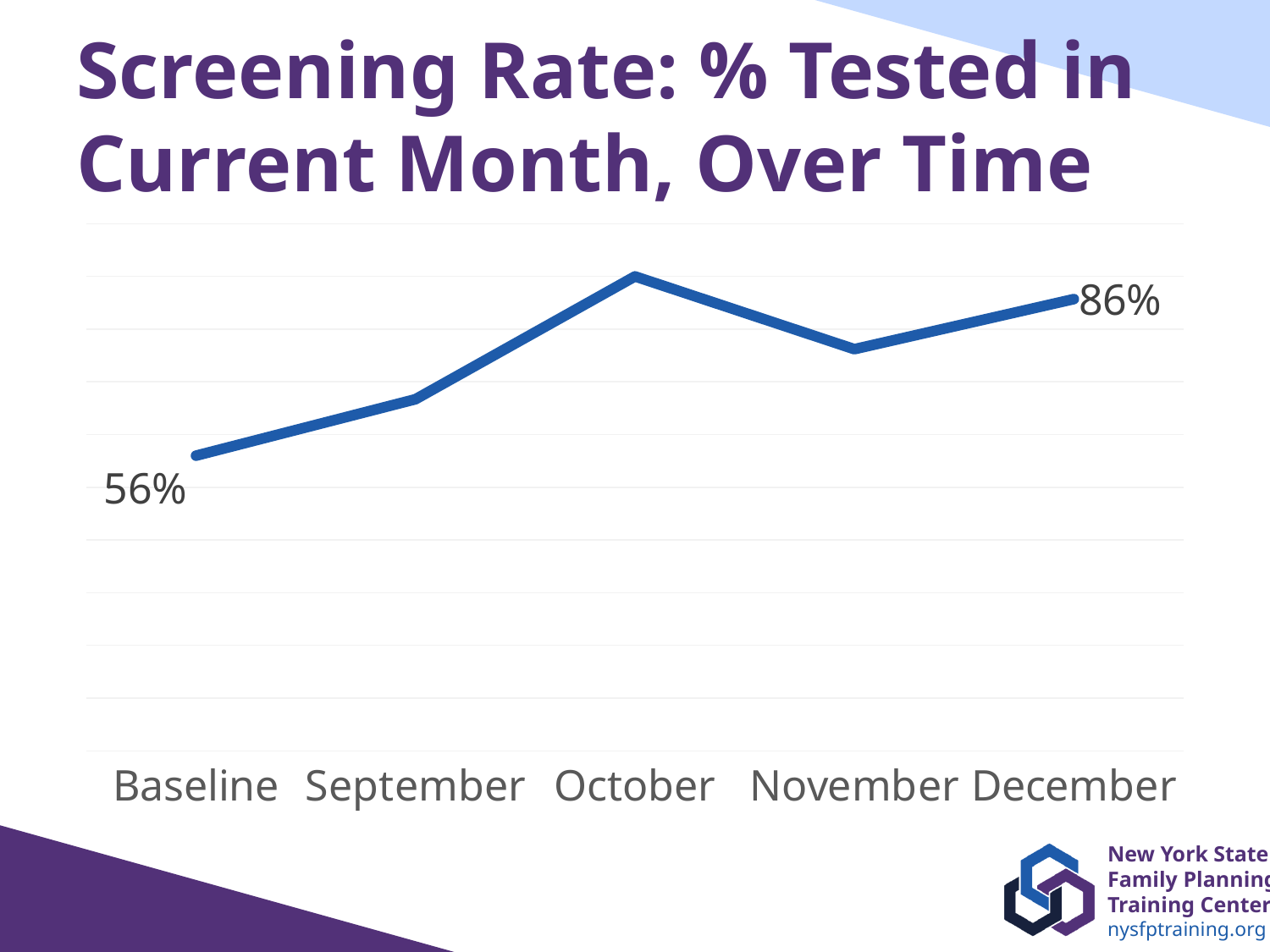
What is the title of the chart on the slide? Screening Rate: % Tested in Current Month, Over Time How many time points are plotted on the chart? 5 What is the screening rate at Baseline? 56% What type of chart is shown on the slide? Line chart Does the screening rate rise or fall from October to November? Fall Which is higher, the screening rate at Baseline or in December? December What is the screening rate in December? 86% Which month has the highest screening rate? October By how many percentage points did the screening rate increase from Baseline to December? 30 percentage points Does the screening rate rise or fall from Baseline to October? Rise Which point on the chart has the lowest screening rate? Baseline Which is higher, the screening rate in October or in November? October